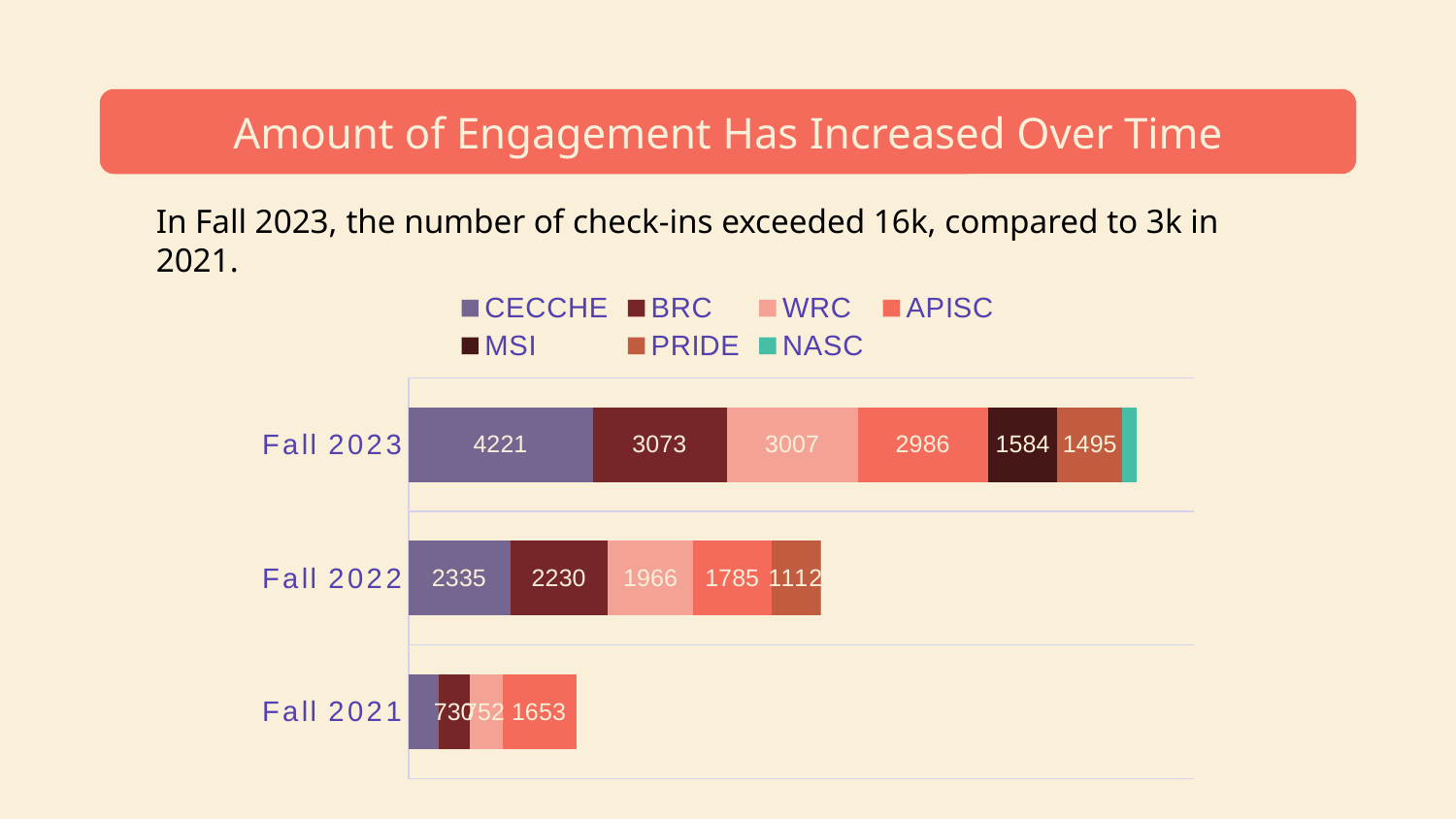
In Fall 2023, which is larger, BRC or WRC? BRC What is the value for APISC in Fall 2021? 1653 Which series has the largest segment in the Fall 2023 bar? CECCHE How many semesters (categories) are shown on the chart? 3 What is the value for BRC in Fall 2022? 2230 What is the value for CECCHE in Fall 2023? 4221 How many series does the legend list? 7 What is the value for MSI in Fall 2023? 1584 Which labelled series has the smallest segment in the Fall 2022 bar? PRIDE How much larger is the CECCHE value in Fall 2023 than in Fall 2022? 1886 What kind of chart is shown on the slide? Stacked bar chart